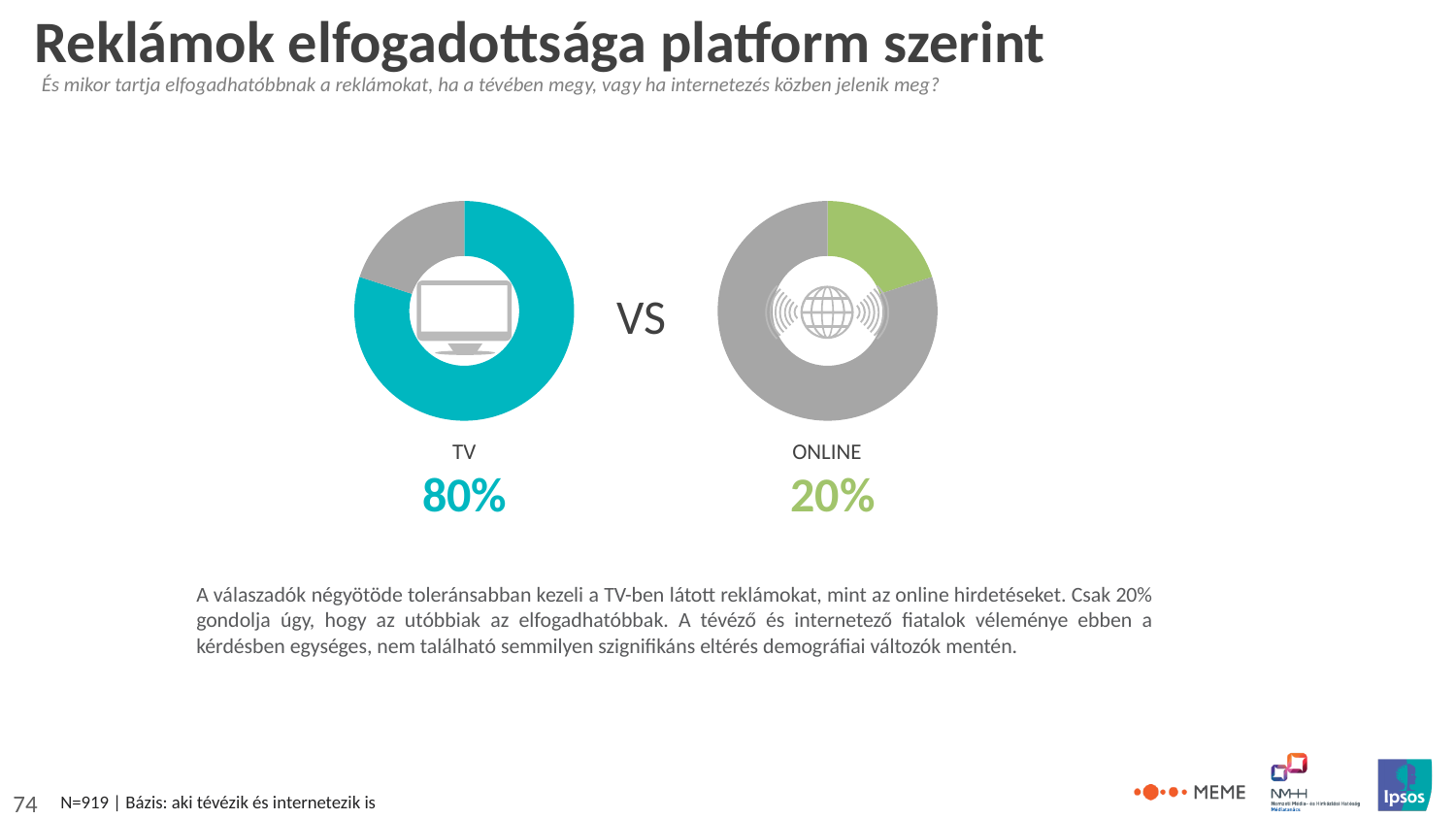
What share of the right donut chart is filled with the green colour for ONLINE? 20% What kind of chart is used to show the TV and ONLINE values? Donut (pie) chart Which platform has the higher value, TV or ONLINE? TV What share of the left donut chart is filled with the teal colour for TV? 80% Which platform has the lower value shown on the slide? ONLINE Is the value for ONLINE greater or less than 50%? less What percentage is shown for ONLINE on the right donut chart? 20% What percentage is shown for TV on the left donut chart? 80% How many donut charts are shown on the slide? 2 What colour is the highlighted slice of the ONLINE donut chart? Green What is the difference in percentage points between the TV value and the ONLINE value? 60 percentage points What is the title of the slide containing the two donut charts? Reklámok elfogadottsága platform szerint